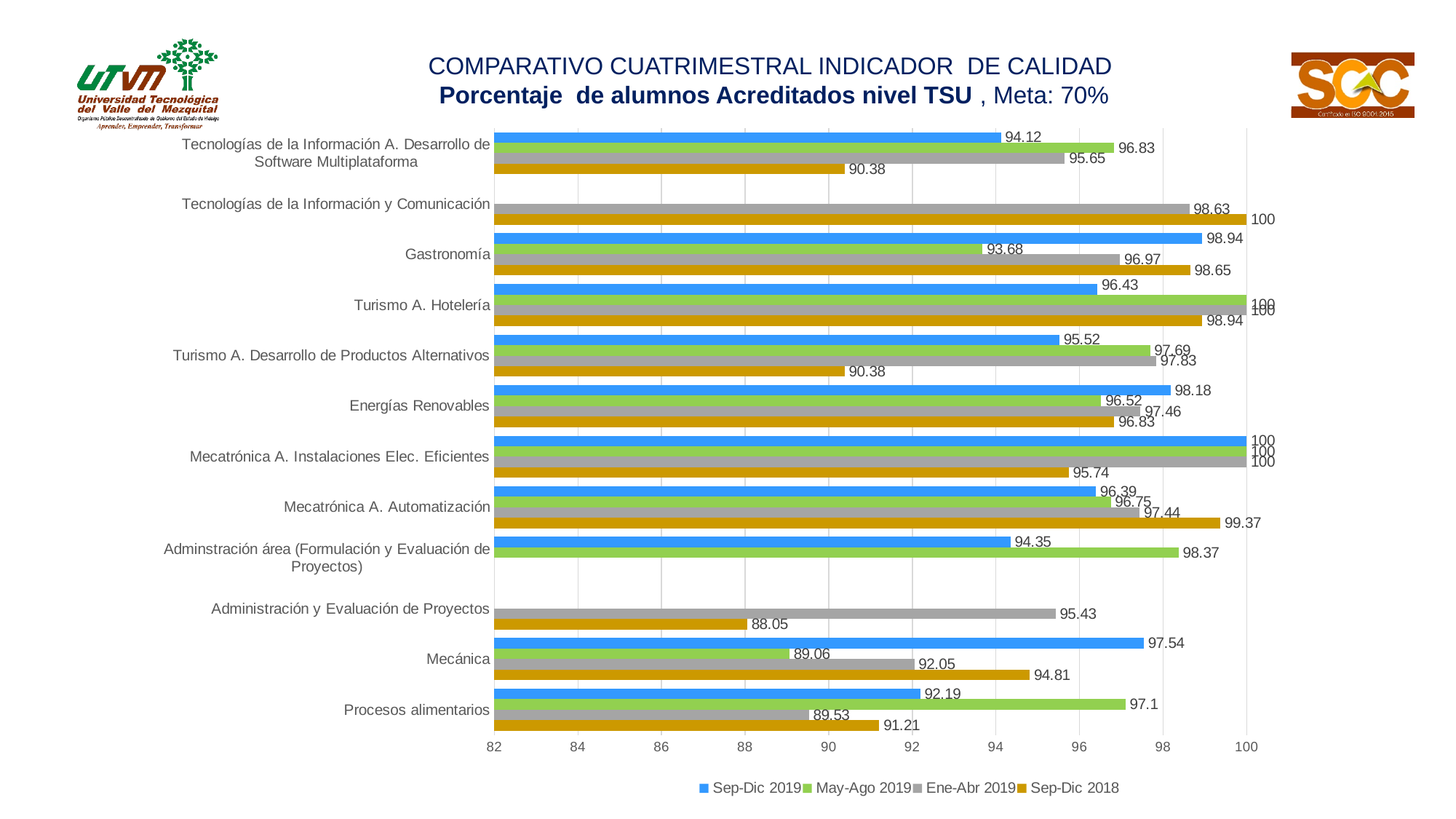
What is the Sep-Dic 2019 value for Mecánica? 97.54 What is the difference between the Sep-Dic 2019 and May-Ago 2019 values for Gastronomía? 5.26 How many categories (programs) are shown on the chart? 12 What target (Meta) is stated in the chart title? 70% How many series does the legend list? 4 What is the Sep-Dic 2018 value for Mecatrónica A. Automatización? 99.37 What type of chart is shown on the slide? bar chart What is the May-Ago 2019 value for Procesos alimentarios? 97.1 For Energías Renovables, which is larger: the Sep-Dic 2019 value or the Ene-Abr 2019 value? Sep-Dic 2019 What is the Ene-Abr 2019 value for Administración y Evaluación de Proyectos? 95.43 Which category has the lowest May-Ago 2019 value? Mecánica Which category has the lowest Sep-Dic 2018 value? Administración y Evaluación de Proyectos